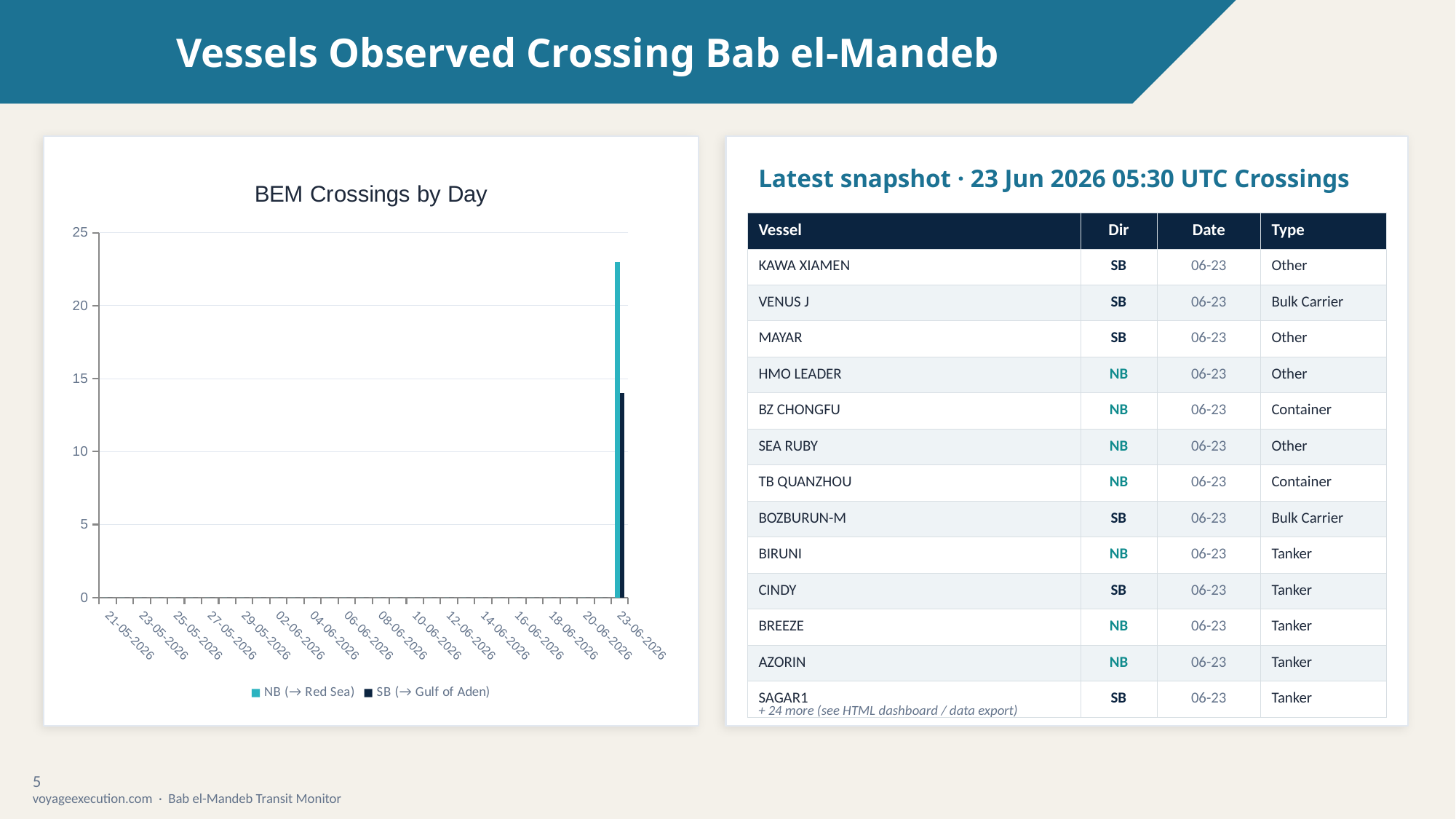
What kind of chart is "BEM Crossings by Day"? bar chart In "BEM Crossings by Day", what is the highest value shown on the vertical axis? 25 How many series does the legend of "BEM Crossings by Day" list? 2 In "BEM Crossings by Day", is the SB (→ Gulf of Aden) value for 23-06-2026 greater or less than 10? greater In "BEM Crossings by Day", which date has the highest NB (→ Red Sea) value? 23-06-2026 In "BEM Crossings by Day", is the NB (→ Red Sea) value for 23-06-2026 greater or less than 25? less What is the title of the chart on the left of the slide? BEM Crossings by Day In "BEM Crossings by Day", which series has the larger value on 23-06-2026, NB (→ Red Sea) or SB (→ Gulf of Aden)? NB (→ Red Sea) In "BEM Crossings by Day", is the NB (→ Red Sea) value for 23-06-2026 greater or less than 20? greater What are the two series named in the legend of "BEM Crossings by Day"? NB (→ Red Sea) and SB (→ Gulf of Aden) In "BEM Crossings by Day", which date has the highest SB (→ Gulf of Aden) value? 23-06-2026